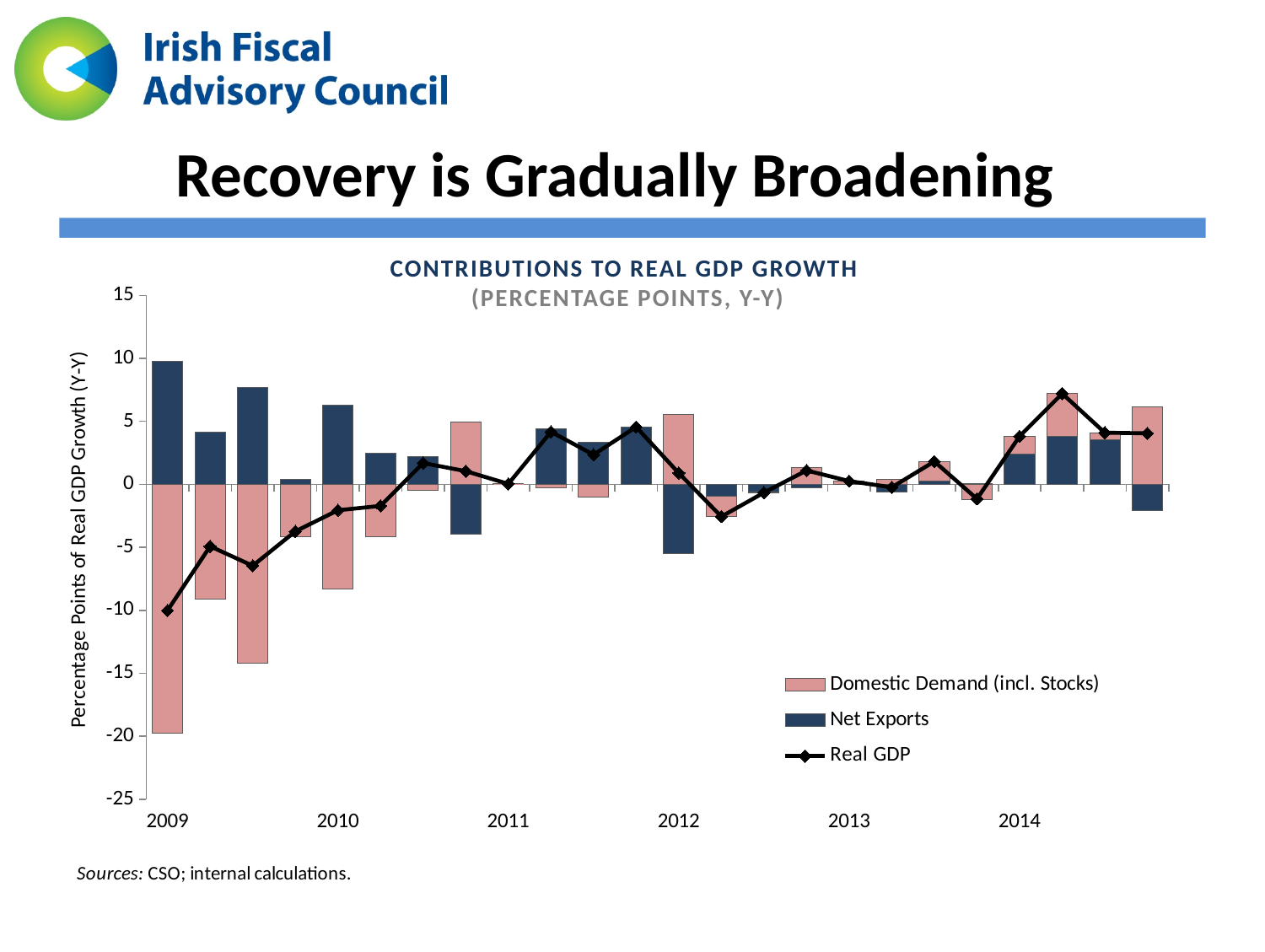
What is the title of the chart? Contributions to Real GDP Growth (Percentage Points, Y-Y) Is the Net Exports value at the start of 2009 greater or less than 5? greater What kind of chart is shown on the slide? A combined bar and line chart How many series does the legend list? 3 How many years are labelled on the x axis? 6 In which year does the Real GDP line reach its highest point? 2014 Is the Domestic Demand (incl. Stocks) value at the start of 2009 greater or less than -15? less Which series is plotted as a black line with diamond markers? Real GDP Is the Real GDP value at the start of 2009 greater or less than -5? less Does the Real GDP line generally rise or fall from 2009 to 2014? rise In which year does the Real GDP line reach its lowest point? 2009